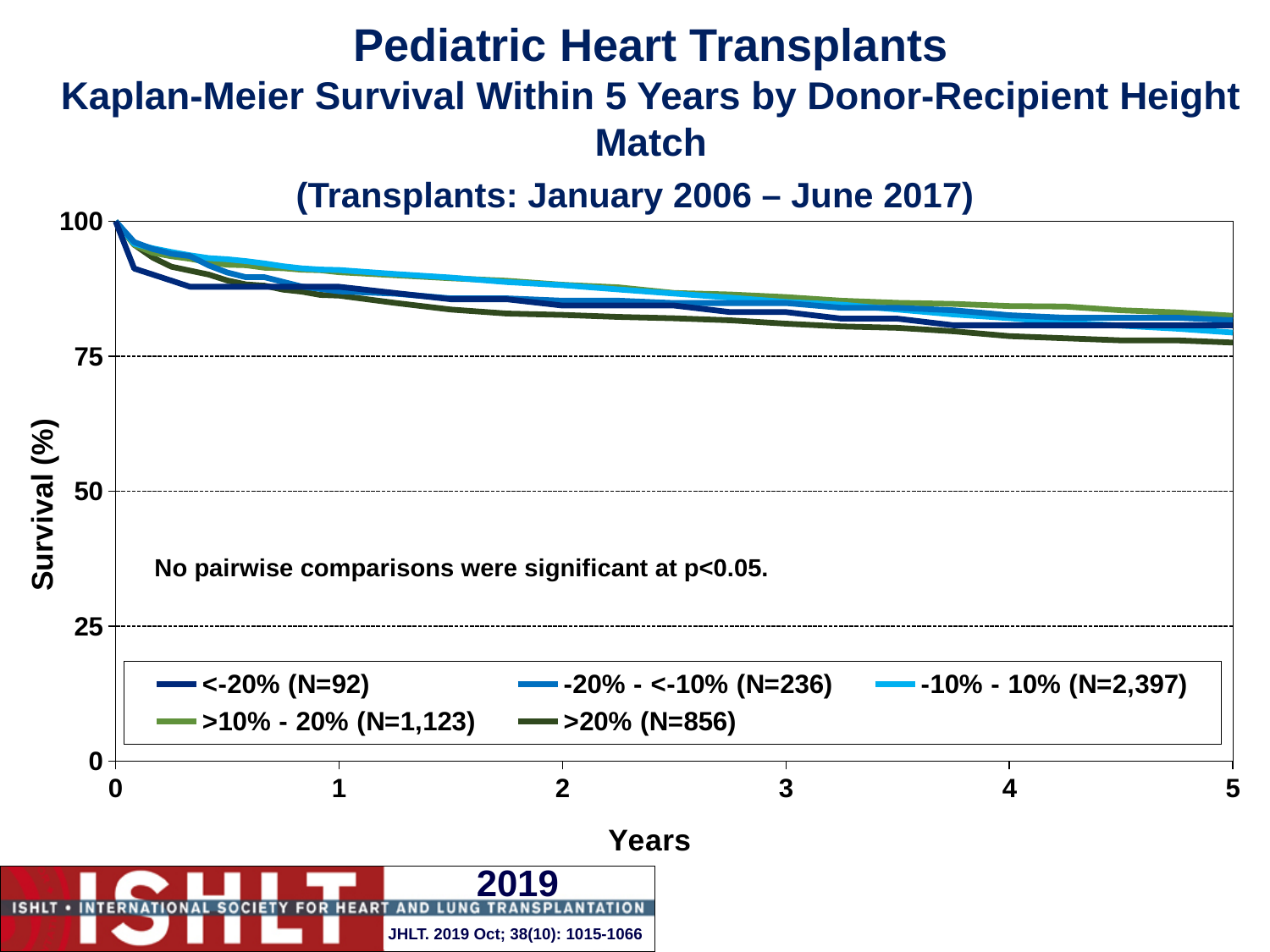
Do the survival curves rise or fall as years increase? fall At year 5, which group has higher survival: >10% - 20% or >20%? >10% - 20% What kind of chart is shown on the slide? line chart What is the survival (%) for all groups at year 0? 100 Is the survival for the >20% group at year 5 greater or less than 75? greater Which group has the lowest survival at year 5? >20% (N=856) What is the N for the -10% - 10% group shown in the legend? 2,397 Is the survival for the <-20% group at year 1 greater or less than 75? greater What is the label of the x axis? Years Is the survival for the -10% - 10% group at year 3 greater or less than 100? less How many series does the legend list? 5